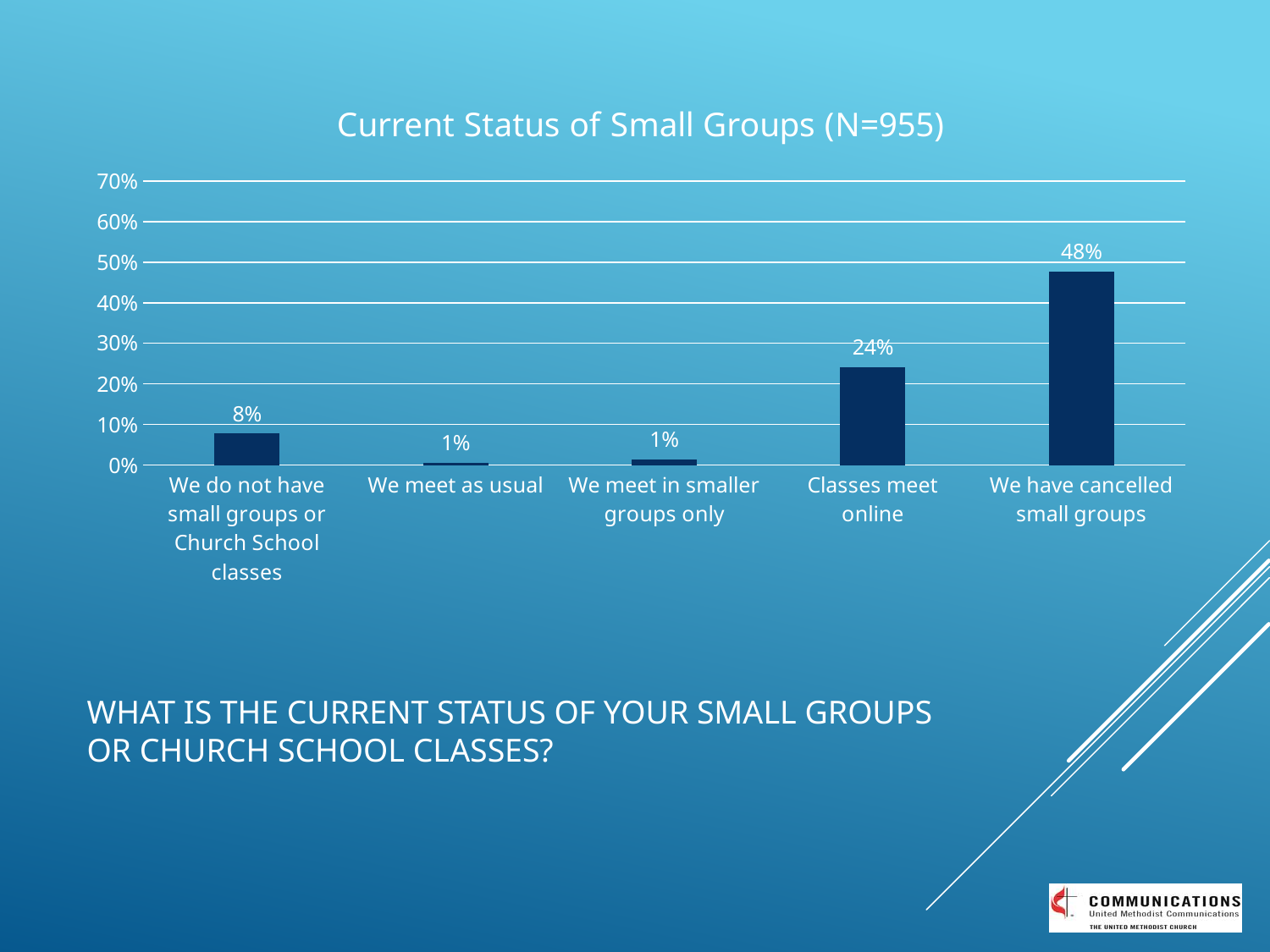
What is the value for "We meet as usual"? 1% What is the highest value shown on the y axis? 70% Which is larger, "Classes meet online" or "We do not have small groups or Church School classes"? Classes meet online What is the value for "Classes meet online"? 24% What kind of chart is shown on the slide? Bar chart What is the title of the chart? Current Status of Small Groups (N=955) Which category has the highest value? We have cancelled small groups What is the difference between "We have cancelled small groups" and "Classes meet online"? 24% How many categories are shown on the x axis? 5 What is the value for "We have cancelled small groups"? 48% Is the value for "We have cancelled small groups" greater or less than 40%? greater What is the value for "We do not have small groups or Church School classes"? 8%